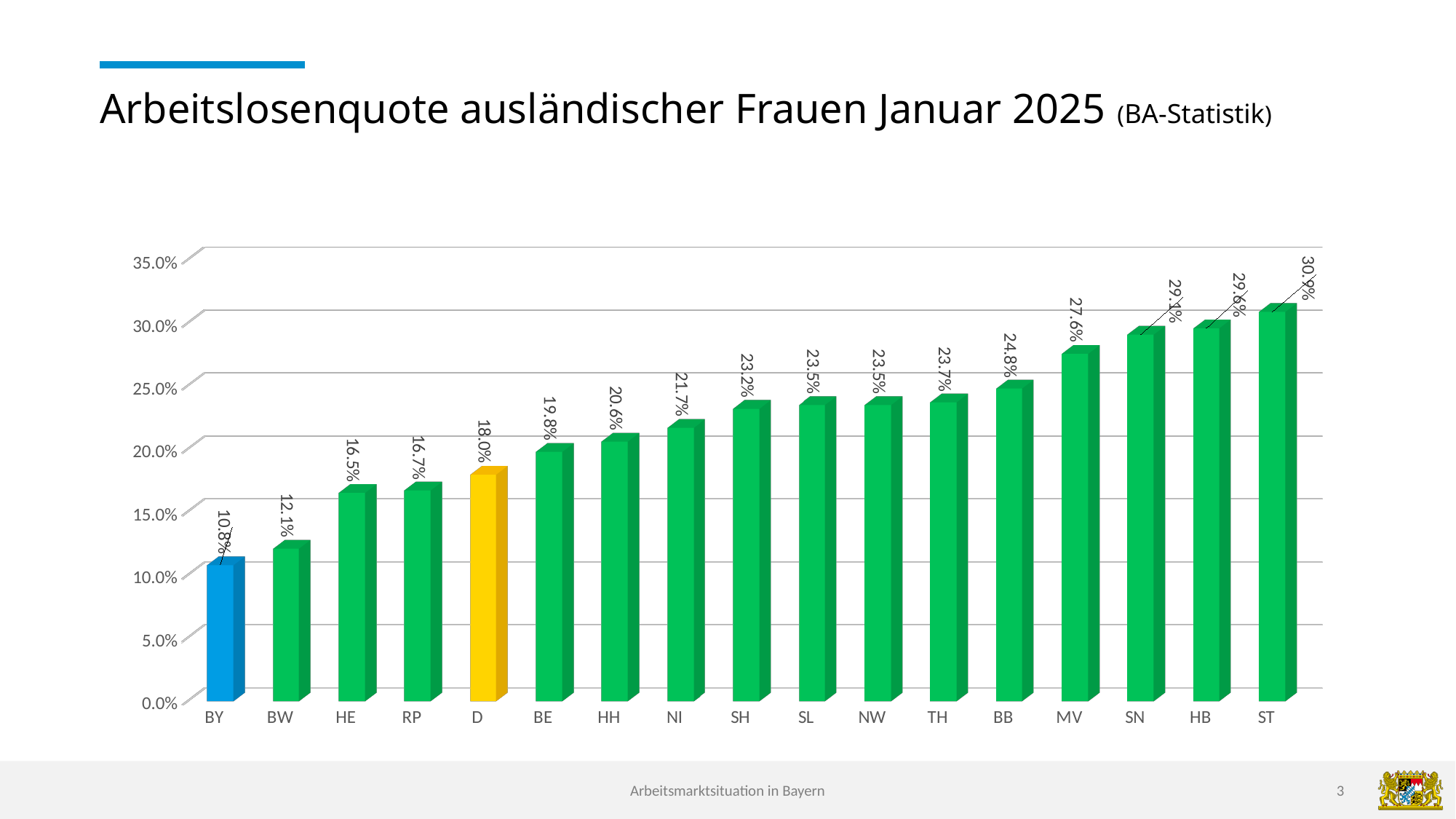
What is the value for BY? 10.8% What is the difference between the values for D and BY? 7.2 percentage points Which category has the highest value? ST What is the value for MV? 27.6% Is the value for NI greater or less than 20.0%? greater How many categories are shown on the x axis? 17 Which is larger, the value for HB or the value for BB? HB What is the difference between the values for ST and BY? 20.1 percentage points What kind of chart is shown on the slide? Bar chart Which category has the lowest value? BY Do the values rise or fall from left to right along the x axis? Rise What is the value for D? 18.0%